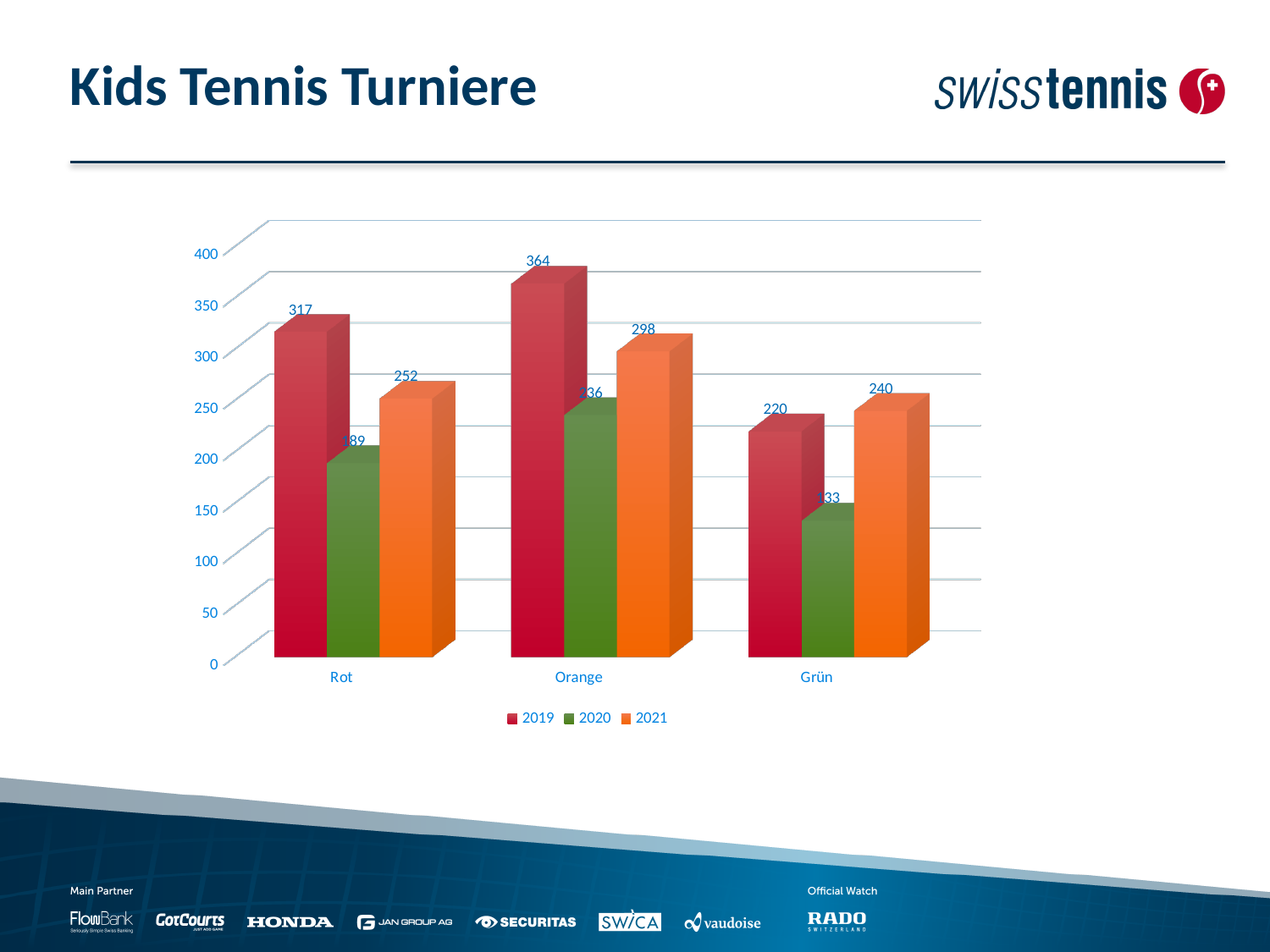
What is the value for Grün in the 2021 series? 240 What is the value for Orange in the 2019 series? 364 How many categories are shown on the x axis? 3 Which category has the lowest value in the 2021 series? Grün How many series does the legend list? 3 Is the value for Grün in the 2020 series greater or less than 150? less Which category has the highest value in the 2019 series? Orange What is the difference between the 2019 values for Orange and Rot? 47 What is the value for Orange in the 2021 series? 298 Which is larger for Grün: the 2019 value or the 2021 value? 2021 What kind of chart is shown on the slide? bar chart What is the value for Rot in the 2019 series? 317